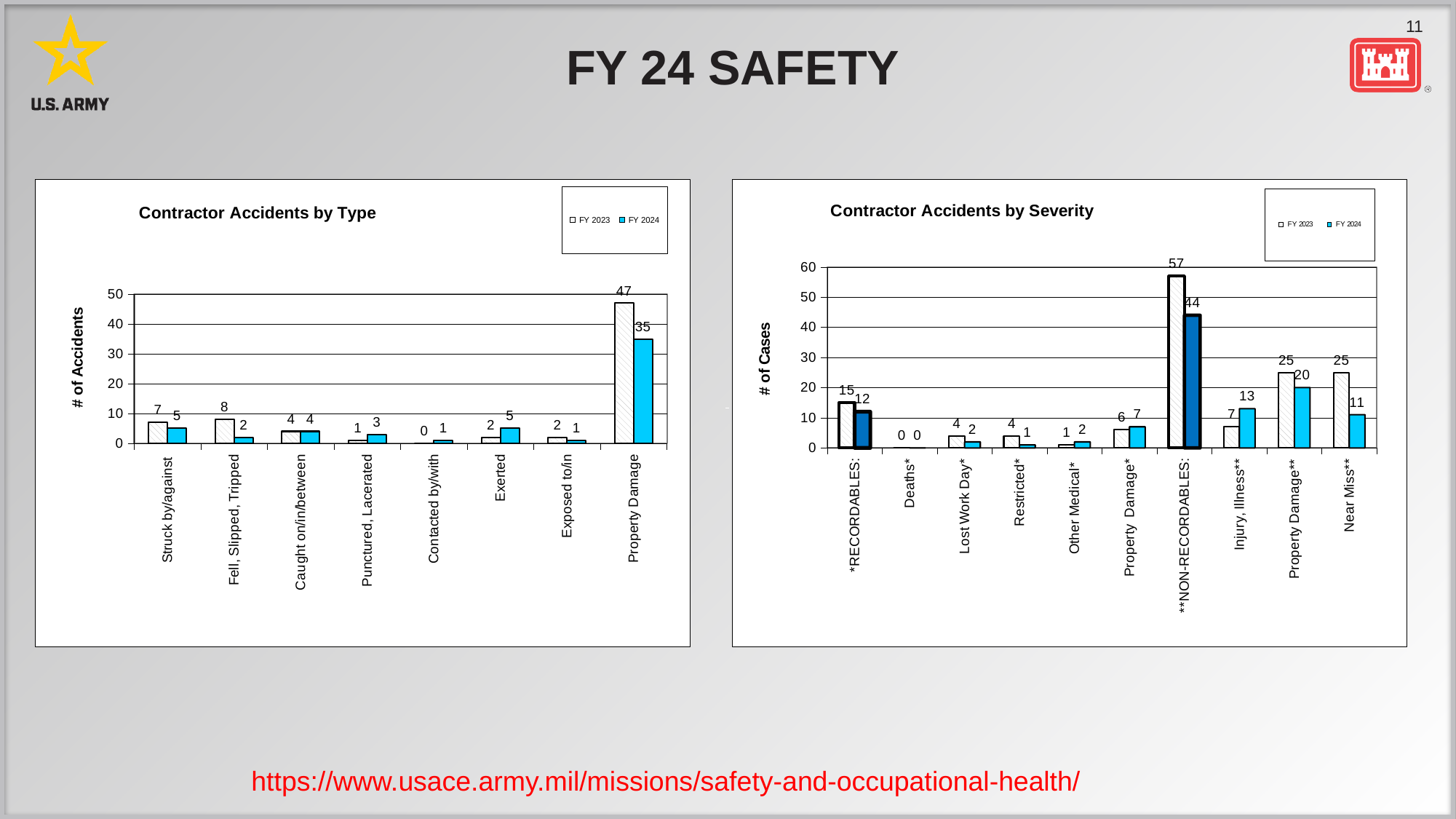
In the Contractor Accidents by Type chart, which is larger for Exerted: FY 2023 or FY 2024? FY 2024 In the Contractor Accidents by Severity chart, what is the FY 2024 value for Injury, Illness**? 13 What kind of chart is the Contractor Accidents by Type chart? Bar chart In the Contractor Accidents by Type chart, how many categories are shown on the x axis? 8 In the Contractor Accidents by Severity chart, which category has the lowest values for both years? Deaths* In the Contractor Accidents by Type chart, what is the FY 2023 value for Fell, Slipped, Tripped? 8 In the Contractor Accidents by Type chart, what is the FY 2024 value for Property Damage? 35 In the Contractor Accidents by Type chart, which category has the highest FY 2023 value? Property Damage How many series does the legend of the Contractor Accidents by Severity chart list? 2 In the Contractor Accidents by Severity chart, what is the FY 2023 value for **NON-RECORDABLES:? 57 In the Contractor Accidents by Severity chart, what is the difference between the FY 2023 and FY 2024 values for Near Miss**? 14 In the Contractor Accidents by Type chart, what is the difference between the FY 2023 and FY 2024 values for Property Damage? 12